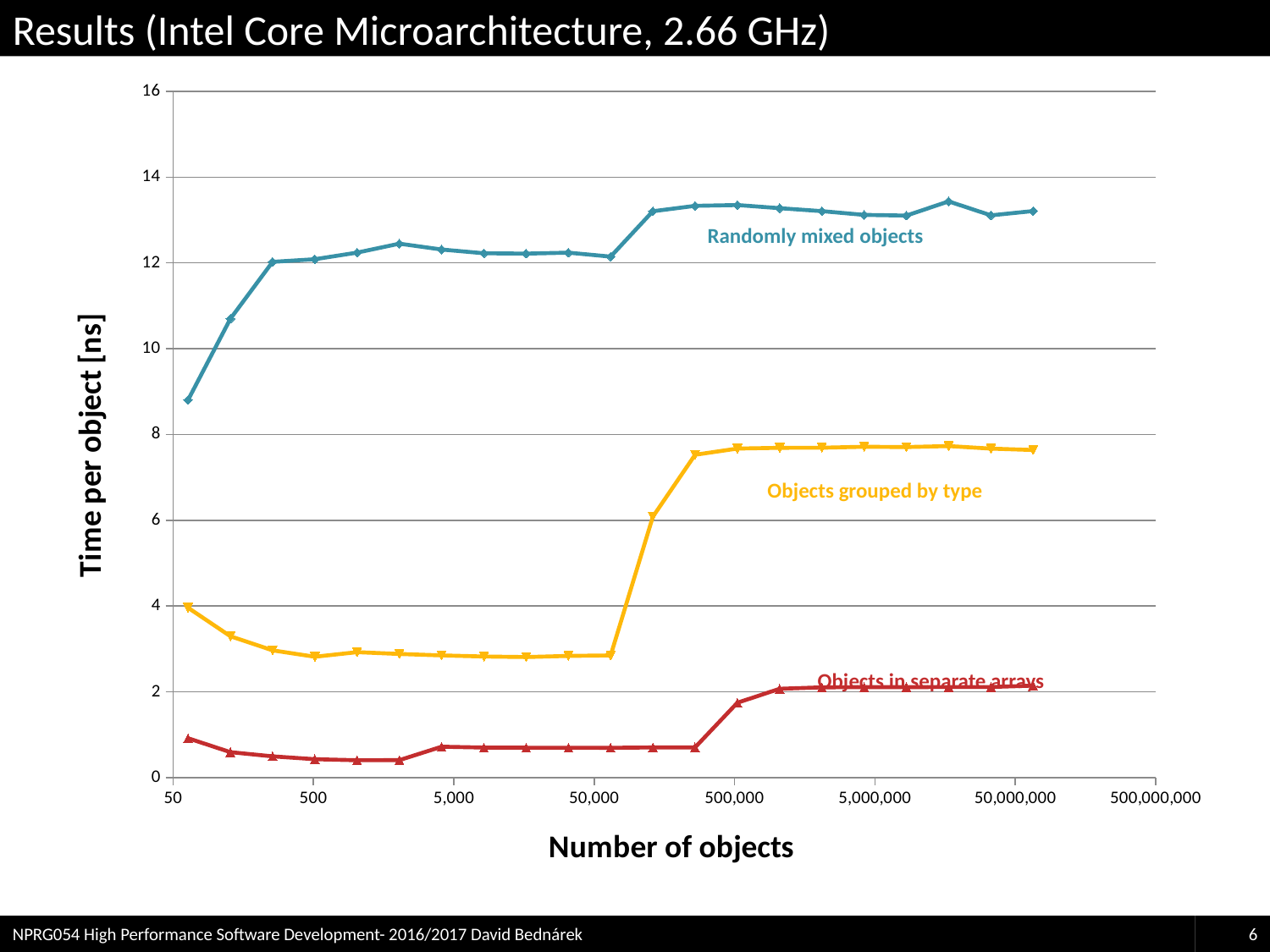
Which series has the lowest time per object across the whole range of object counts? Objects in separate arrays Which series has the highest time per object across the whole range of object counts? Randomly mixed objects At 500,000 objects, which series has the larger time per object: Objects grouped by type or Objects in separate arrays? Objects grouped by type Is the time per object for Randomly mixed objects at 50,000,000 objects greater or less than 12? greater Does the time per object for Objects grouped by type rise or fall between 50,000 and 500,000 objects? rise Is the time per object for Objects grouped by type at 5,000,000 objects greater or less than 6? greater Is the time per object for Objects grouped by type at 5,000 objects greater or less than 4? less What is the label on the x axis of the chart? Number of objects What kind of chart is shown on the slide? line chart What is the label on the y axis of the chart? Time per object [ns] How many data series are plotted on the chart? 3